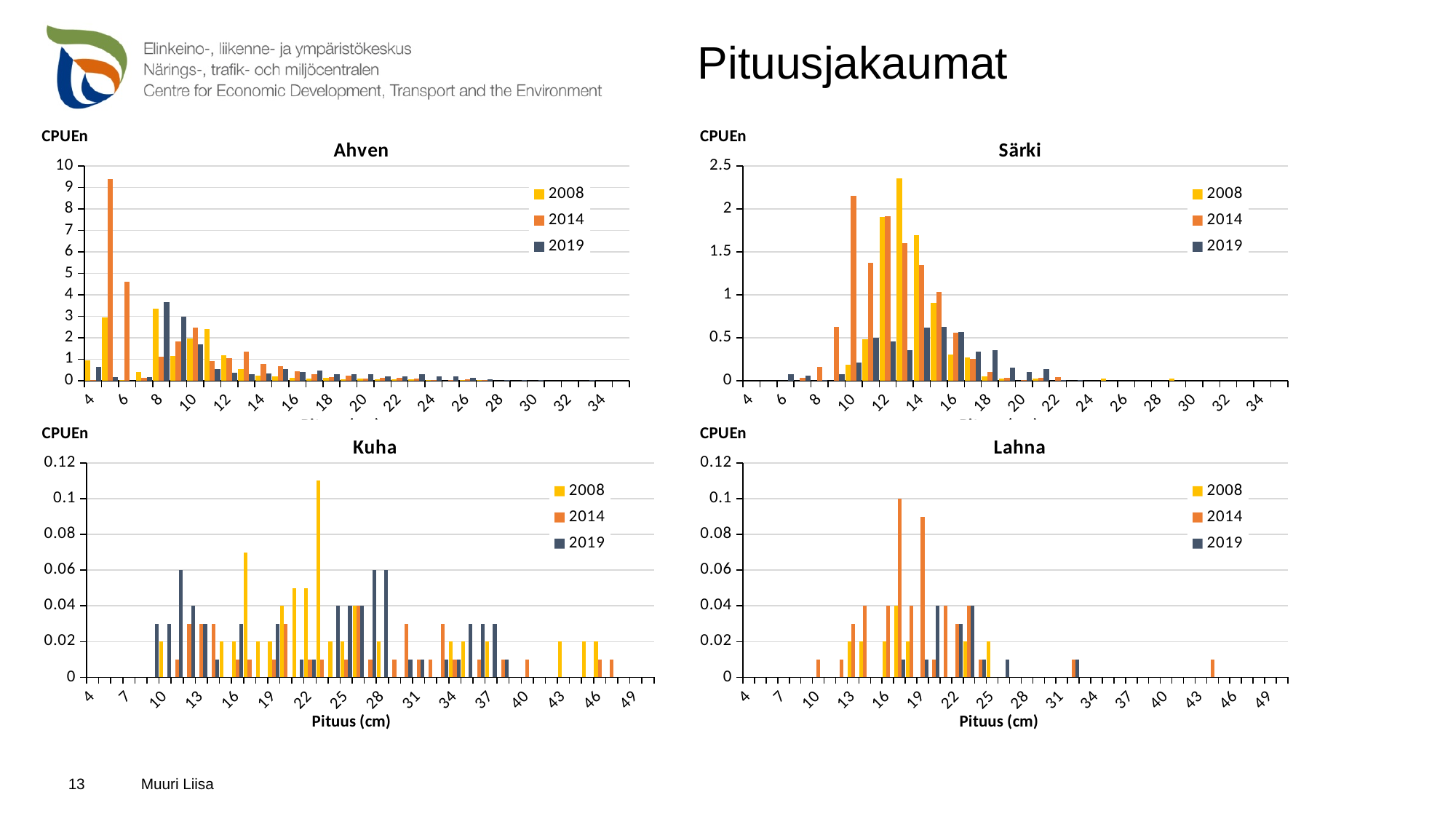
Which years are listed in the legend of the Kuha chart? 2008, 2014, 2019 In the Lahna chart, is the tallest 2019 bar greater or less than 0.06? less In the Kuha chart, which series has the tallest bar overall? 2008 In the Särki chart, is the tallest 2008 bar greater or less than 2? greater What is the x-axis label on the Lahna chart? Pituus (cm) In the Lahna chart, which series has the tallest bar overall? 2014 What kind of chart is the Ahven chart? bar chart In the Kuha chart, is the tallest 2008 bar greater or less than 0.1? greater How many series does the legend of the Särki chart list? 3 In the Särki chart, which series has the tallest bar overall? 2008